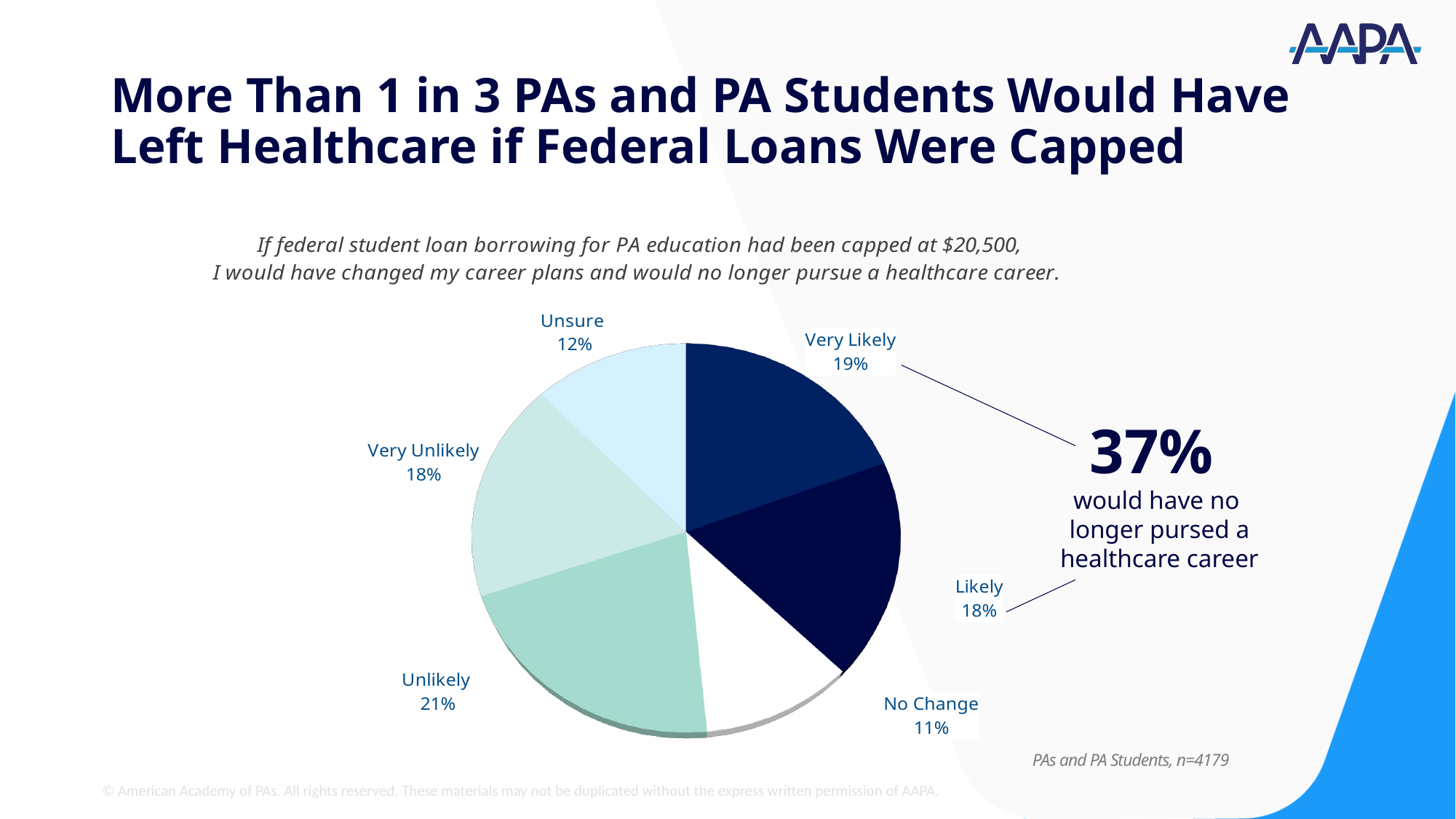
What is the sample size noted on the slide for PAs and PA Students? n=4179 What kind of chart is shown on the slide? pie chart Which response category has the largest share of the pie? Unlikely Which is larger, the share for "Very Likely" or the share for "Unsure"? Very Likely Which response category has the smallest share of the pie? No Change What percentage of respondents answered "Unlikely"? 21% What is the difference in percentage points between "Unlikely" and "No Change"? 10 What is the combined percentage of "Very Likely" and "Likely" responses? 37% What percentage of respondents answered "No Change"? 11% What percentage of respondents answered "Unsure"? 12% What percentage of respondents answered "Very Likely"? 19% How many response categories are shown in the pie chart? 6